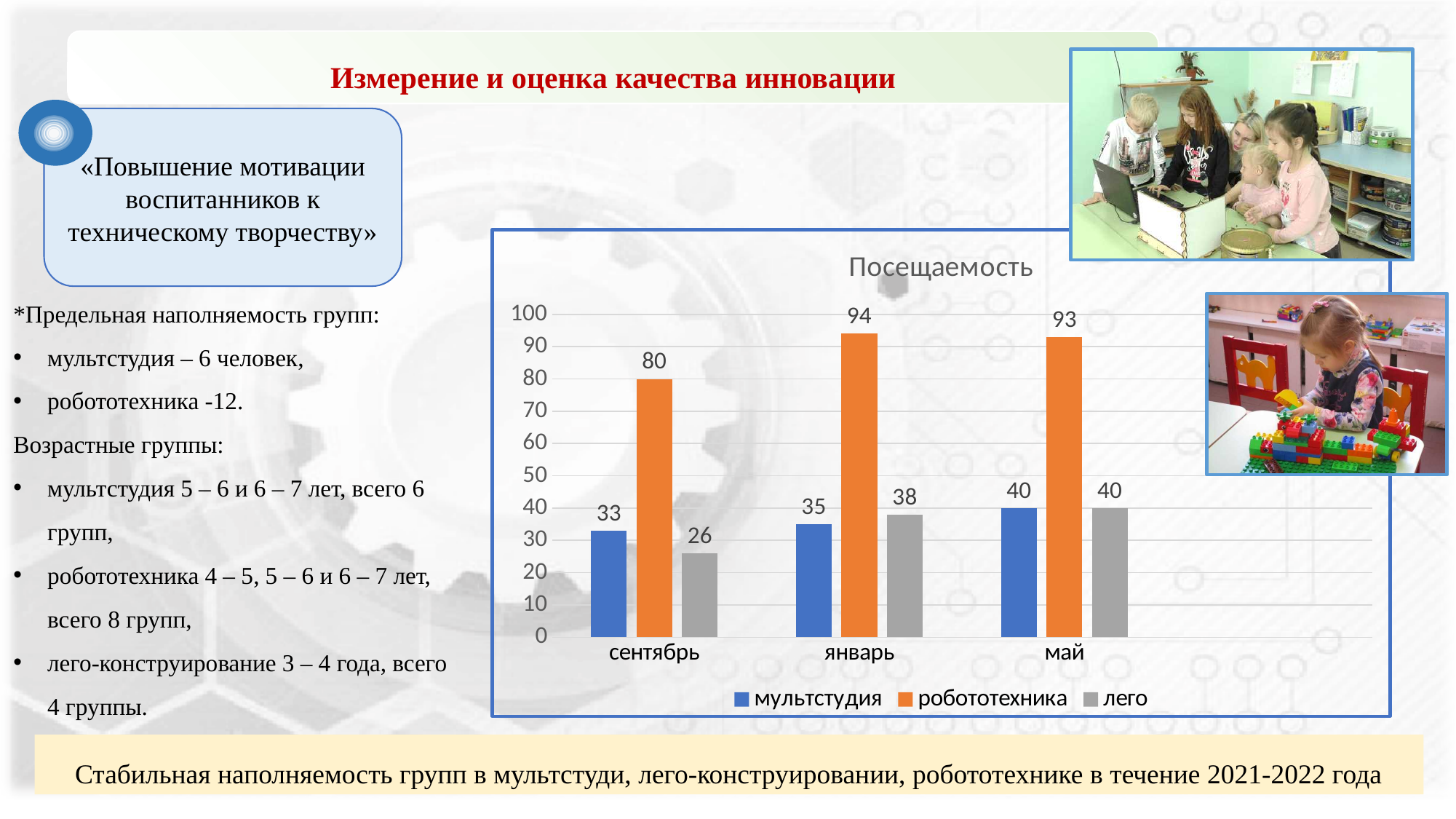
Which is larger in январь: мультстудия or лего? лего How many series does the legend list? 3 Do the values for мультстудия rise or fall from сентябрь to май? rise What kind of chart is shown? bar chart In which month is the value for лего lowest? сентябрь What is the value for лего in сентябрь? 26 What is the value for мультстудия in май? 40 What is the value for робототехника in январь? 94 How many months are shown on the x axis? 3 In which month is the value for робототехника highest? январь Is the value for робототехника in май greater or less than 90? greater What is the difference between the робототехника value in январь and in сентябрь? 14